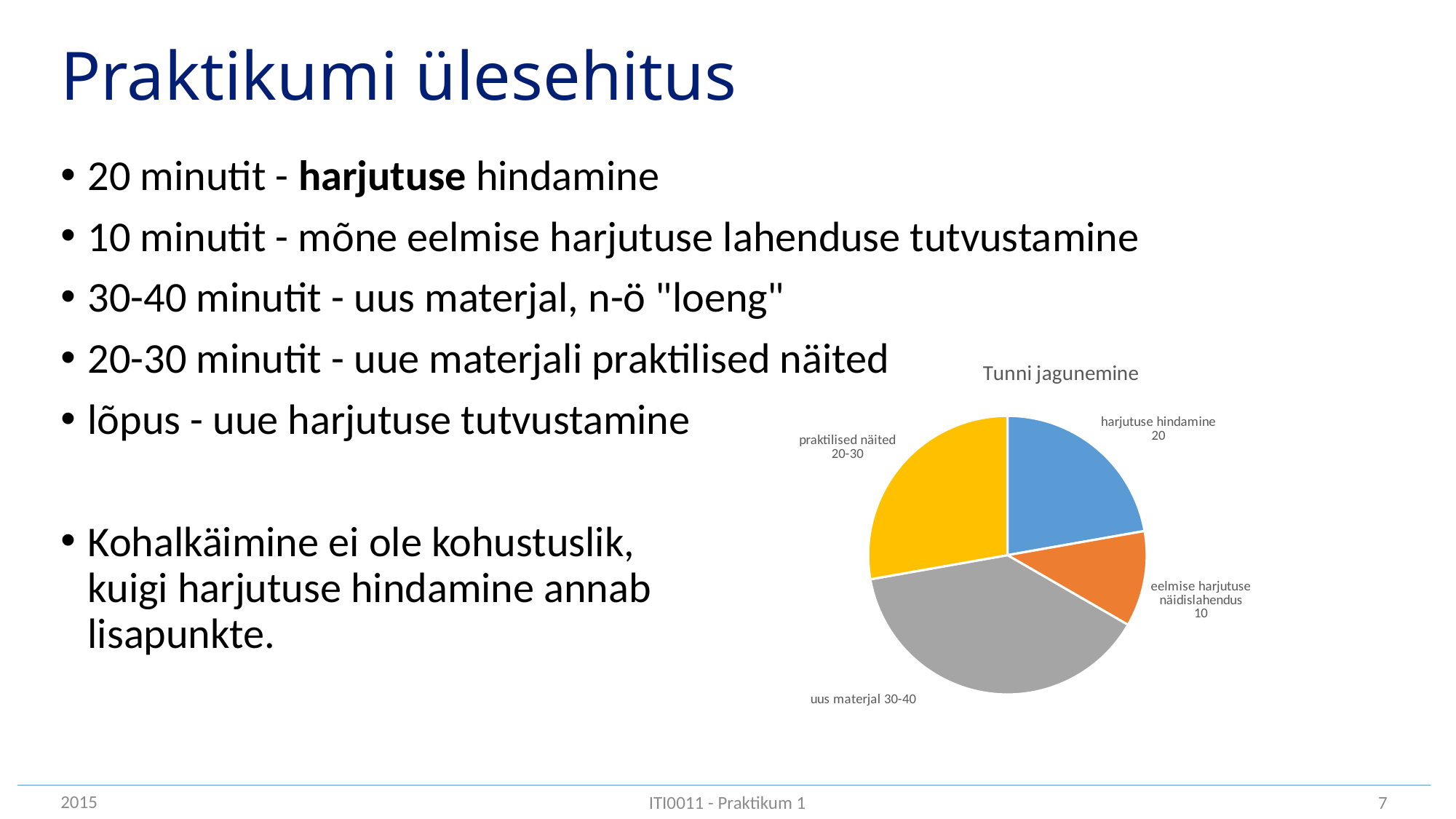
What is the title of the chart? Tunni jagunemine How many slices does the pie chart have? 4 Which slice of the pie chart is the smallest? eelmise harjutuse näidislahendus What value is shown for eelmise harjutuse näidislahendus? 10 Which is larger, the slice for harjutuse hindamine or the slice for eelmise harjutuse näidislahendus? harjutuse hindamine What is the difference between the values for harjutuse hindamine and eelmise harjutuse näidislahendus? 10 Which slice of the pie chart is coloured grey? uus materjal 30-40 Which is larger, the slice for praktilised näited or the slice for harjutuse hindamine? praktilised näited Which slice of the pie chart is the largest? uus materjal 30-40 What kind of chart is shown on the slide? pie chart What value is shown for harjutuse hindamine? 20